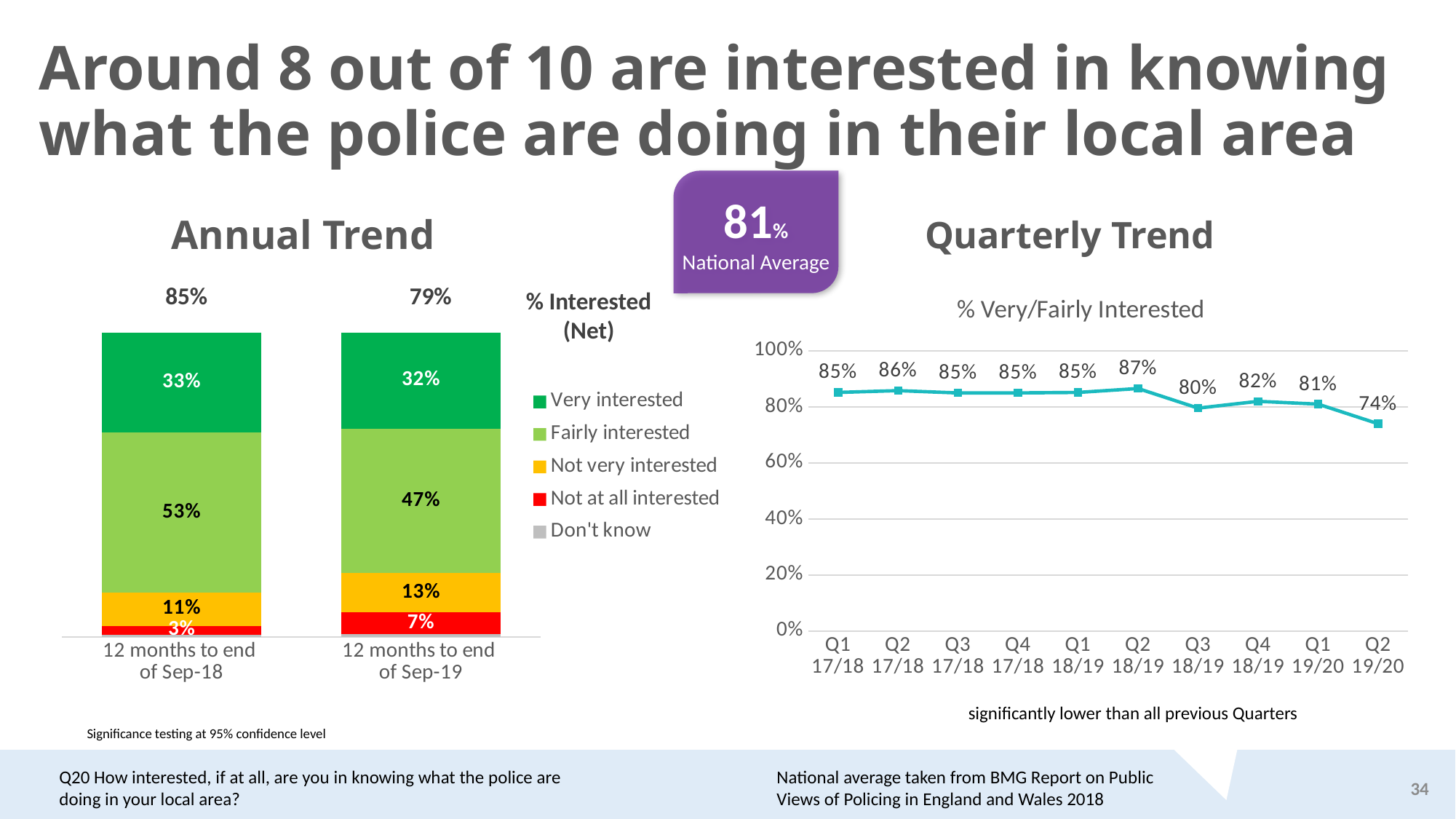
In the Quarterly Trend chart, which quarter has the lowest value? Q2 19/20 In the Quarterly Trend chart, what is the difference between Q2 18/19 and Q3 18/19? 7% In the Annual Trend chart, what percentage were 'Not at all interested' in the 12 months to end of Sep-19? 7% In the Annual Trend chart, what percentage were 'Fairly interested' in the 12 months to end of Sep-18? 53% In the Annual Trend chart, which period has the larger 'Not very interested' share, Sep-18 or Sep-19? 12 months to end of Sep-19 In the Annual Trend chart, what is the net % Interested for the 12 months to end of Sep-19? 79% In the Annual Trend chart, what is the difference between the 'Fairly interested' values for Sep-18 and Sep-19? 6% In the Quarterly Trend chart, which quarter has the highest value? Q2 18/19 In the Quarterly Trend chart, what is the value for Q2 19/20? 74% What kind of chart is the Annual Trend chart? Stacked bar chart How many quarters are plotted in the Quarterly Trend chart? 10 How many series does the legend of the Annual Trend chart list? 5